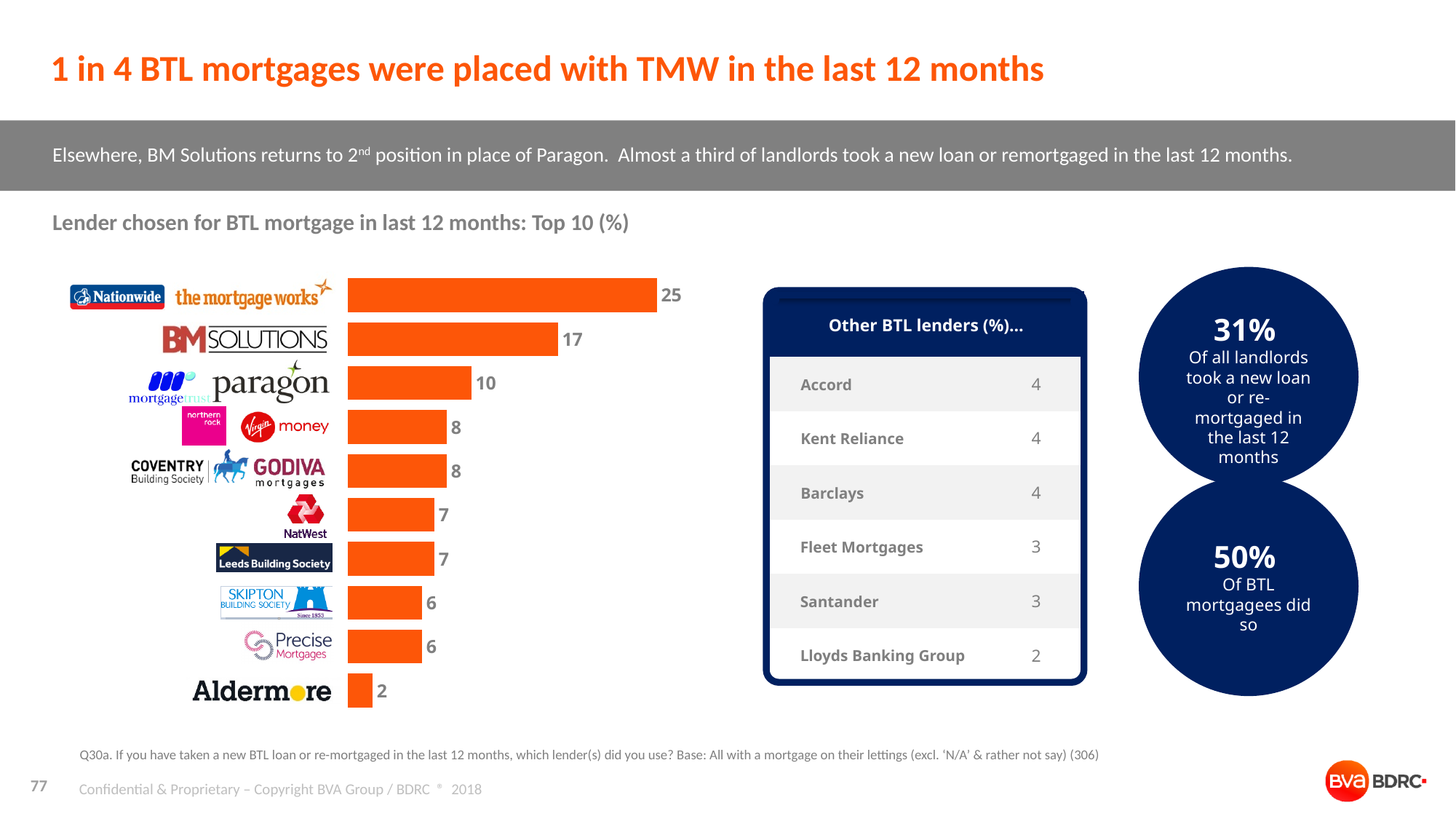
Which lender has the lowest value in the bar chart? Aldermore What value is shown for Paragon in the bar chart? 10 How many lenders are shown in the bar chart? 10 What percentage of BTL mortgages in the last 12 months were placed with The Mortgage Works (Nationwide)? 25 What type of chart is used to show the lender chosen for BTL mortgage? Bar chart Which has a larger value in the bar chart, Paragon or NatWest? Paragon What value is shown for Aldermore in the bar chart? 2 Which lender has the highest value in the bar chart? The Mortgage Works (Nationwide) What value is shown for BM Solutions in the bar chart? 17 What is the difference between the values for The Mortgage Works and BM Solutions? 8 What value is shown for Skipton Building Society in the bar chart? 6 What is the title of the chart? Lender chosen for BTL mortgage in last 12 months: Top 10 (%)